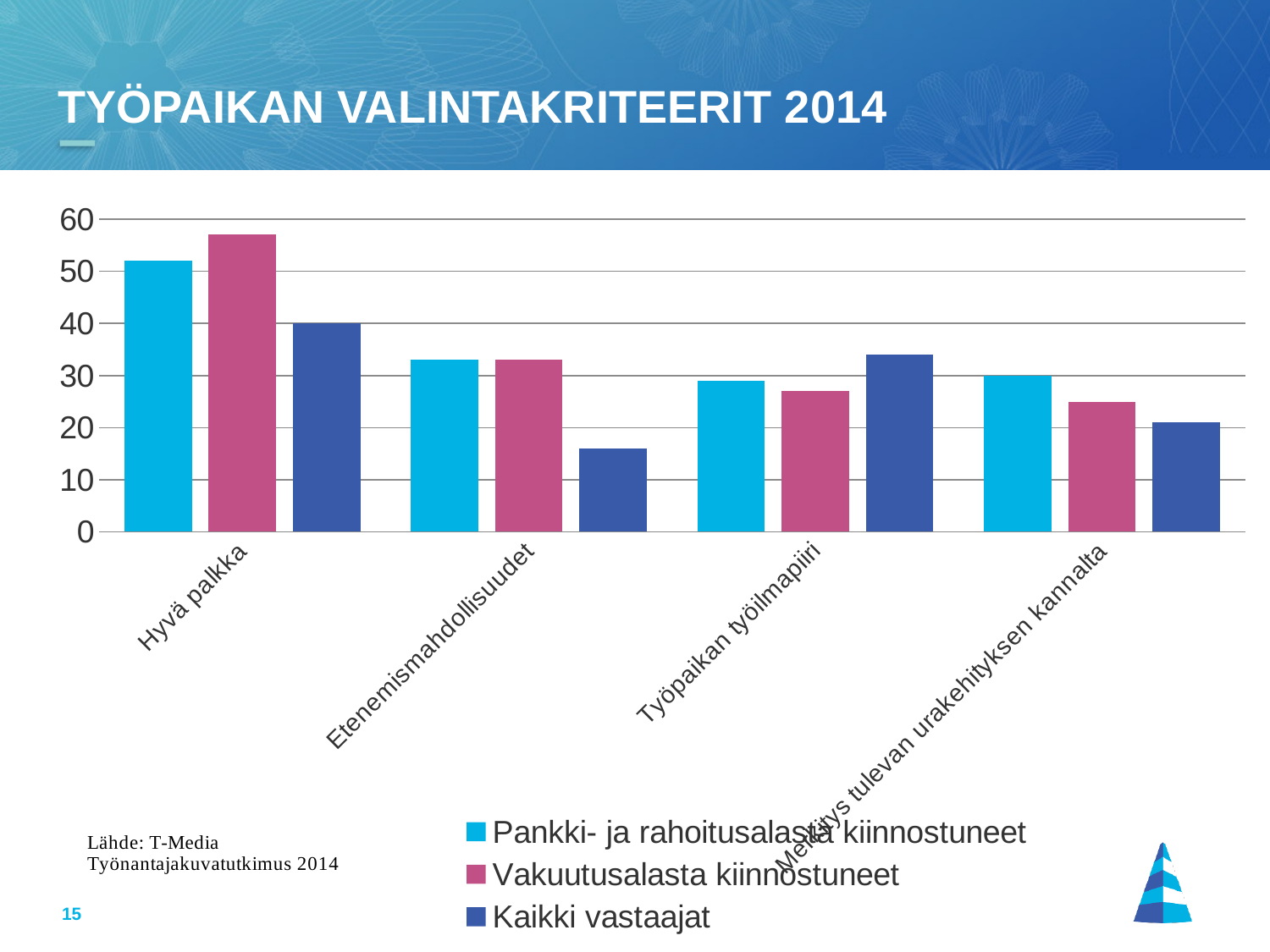
Which category has the lowest value for the Kaikki vastaajat series? Etenemismahdollisuudet For Työpaikan työilmapiiri, which is larger: Kaikki vastaajat or Vakuutusalasta kiinnostuneet? Kaikki vastaajat How many categories are shown on the x axis? 4 Is the value for Vakuutusalasta kiinnostuneet in Hyvä palkka greater or less than 50? greater Is the value for Kaikki vastaajat in Etenemismahdollisuudet greater or less than 20? less Which series is shown in dark blue in the legend? Kaikki vastaajat How many series does the legend list? 3 What kind of chart is shown on the slide? bar chart Is the value for Vakuutusalasta kiinnostuneet in Merkitys tulevan urakehityksen kannalta greater or less than 30? less Which series has the tallest bar for Hyvä palkka? Vakuutusalasta kiinnostuneet What is the title of the slide? TYÖPAIKAN VALINTAKRITEERIT 2014 Which category has the highest value for the Kaikki vastaajat series? Hyvä palkka